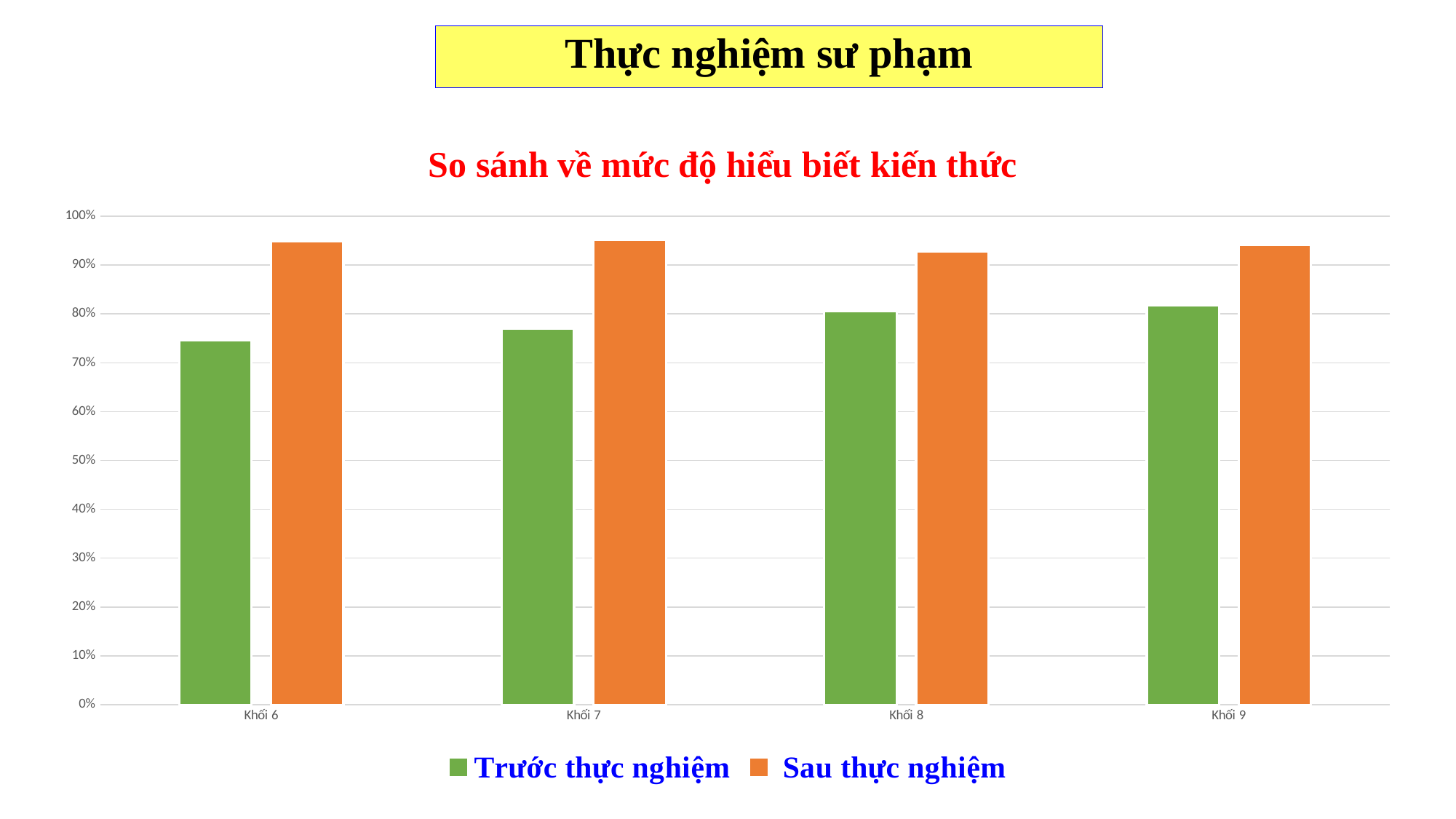
What kind of chart is shown on the slide? bar chart Which category has the lowest value for 'Trước thực nghiệm'? Khối 6 Is the value for 'Trước thực nghiệm' at Khối 6 greater or less than 70%? greater What is the title of the chart? So sánh về mức độ hiểu biết kiến thức How many categories are shown on the x axis? 4 Which category has the lowest value for 'Sau thực nghiệm'? Khối 8 Is the value for 'Trước thực nghiệm' at Khối 7 greater or less than 80%? less Which colour represents the series 'Sau thực nghiệm'? orange Is the value for 'Sau thực nghiệm' at Khối 8 greater or less than 90%? greater At Khối 6, which is larger: 'Trước thực nghiệm' or 'Sau thực nghiệm'? Sau thực nghiệm Do the values for 'Trước thực nghiệm' rise or fall from Khối 6 to Khối 9? rise How many series does the legend list? 2